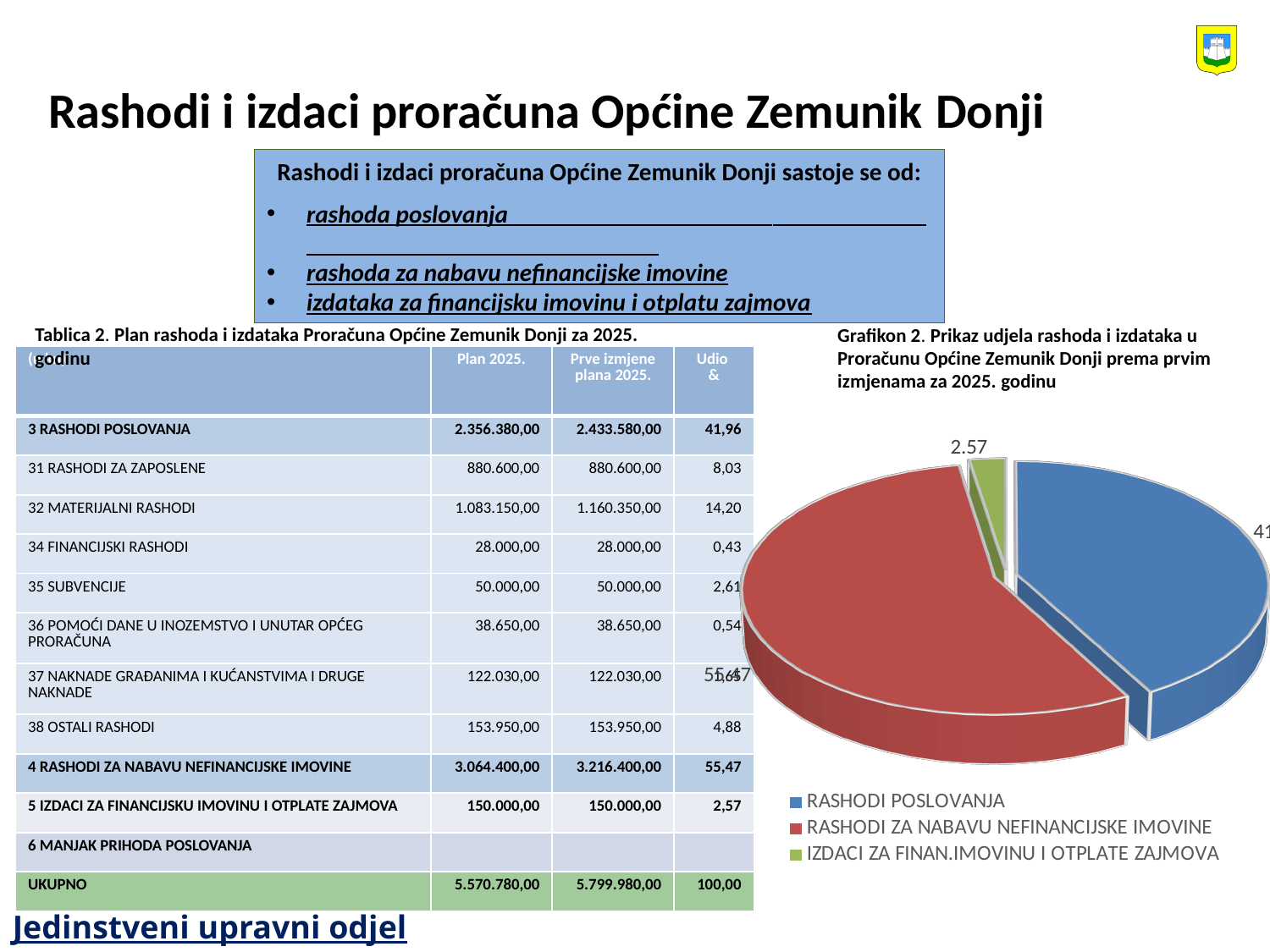
What colour is the RASHODI POSLOVANJA slice in the pie chart? blue Which category has the smallest slice in the pie chart? IZDACI ZA FINAN.IMOVINU I OTPLATE ZAJMOVA In the pie chart, what value is labelled on the slice for IZDACI ZA FINAN.IMOVINU I OTPLATE ZAJMOVA? 2.57 What colour is the RASHODI ZA NABAVU NEFINANCIJSKE IMOVINE slice in the pie chart? red How many entries does the legend of the pie chart list? 3 In the pie chart, what value is labelled on the slice for RASHODI ZA NABAVU NEFINANCIJSKE IMOVINE? 55.47 In the pie chart, which slice is larger: RASHODI POSLOVANJA or RASHODI ZA NABAVU NEFINANCIJSKE IMOVINE? RASHODI ZA NABAVU NEFINANCIJSKE IMOVINE Which category has the largest slice in the pie chart? RASHODI ZA NABAVU NEFINANCIJSKE IMOVINE What share of the pie does the IZDACI ZA FINAN.IMOVINU I OTPLATE ZAJMOVA slice represent, according to its label? 2.57 How many slices does the pie chart (Grafikon 2) have? 3 What kind of chart is Grafikon 2 on the slide? pie chart